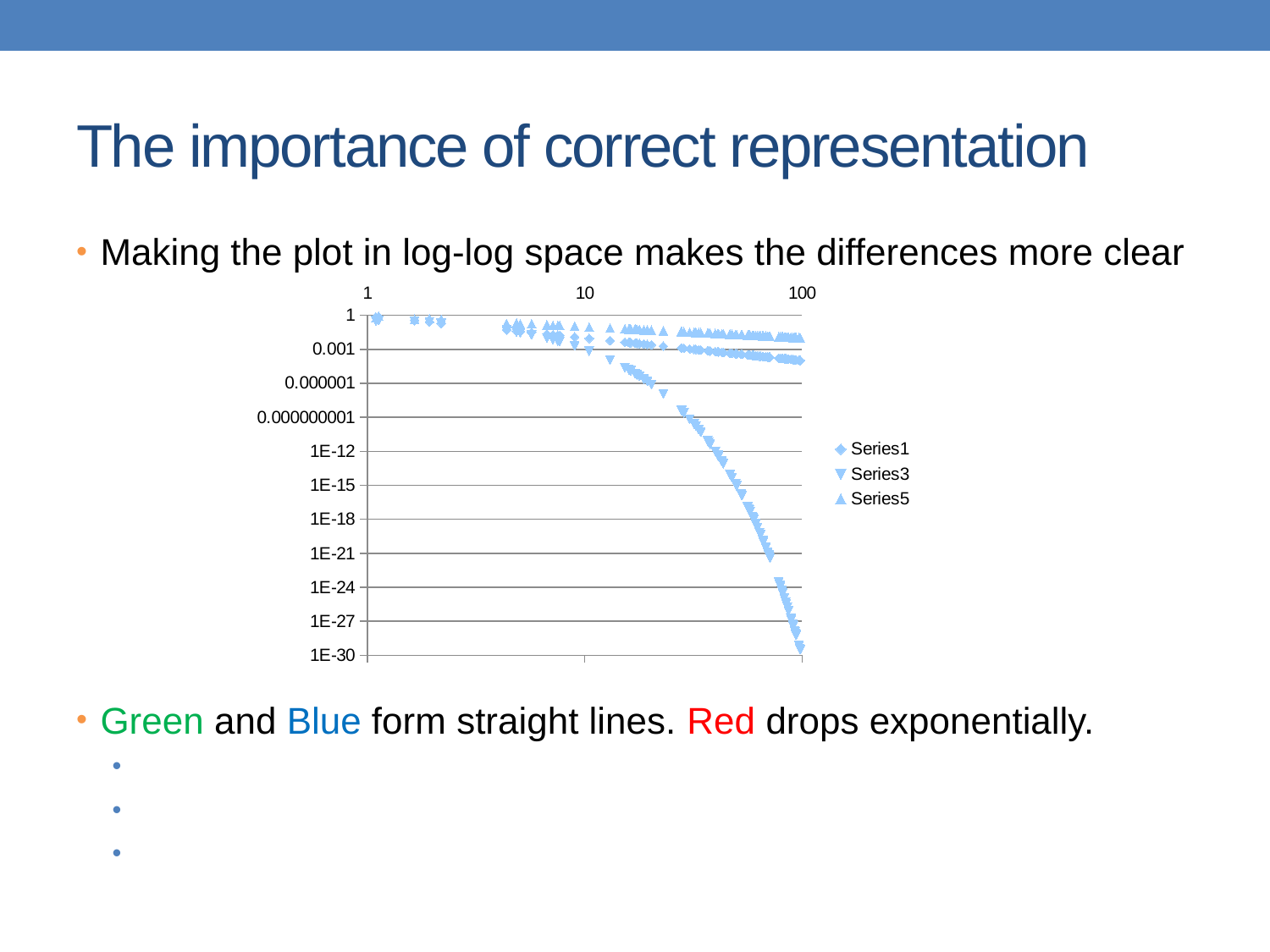
Is the value for Series1 near x = 100 greater or less than 0.000001? greater Which series are listed in the legend? Series1, Series3, Series5 How many series does the legend list? 3 Do the plotted values rise or fall as x increases along the x axis? fall Is the value for Series5 near x = 100 greater or less than 0.001? greater Which series drops most steeply as x approaches 100? Series3 What kind of chart is shown on the slide? scatter chart Which series has the higher values near x = 100, Series1 or Series3? Series1 What is the lowest tick label shown on the y axis? 1E-30 Is the value for Series3 near x = 100 greater or less than 1E-21? less What is the highest tick label shown on the x axis? 100